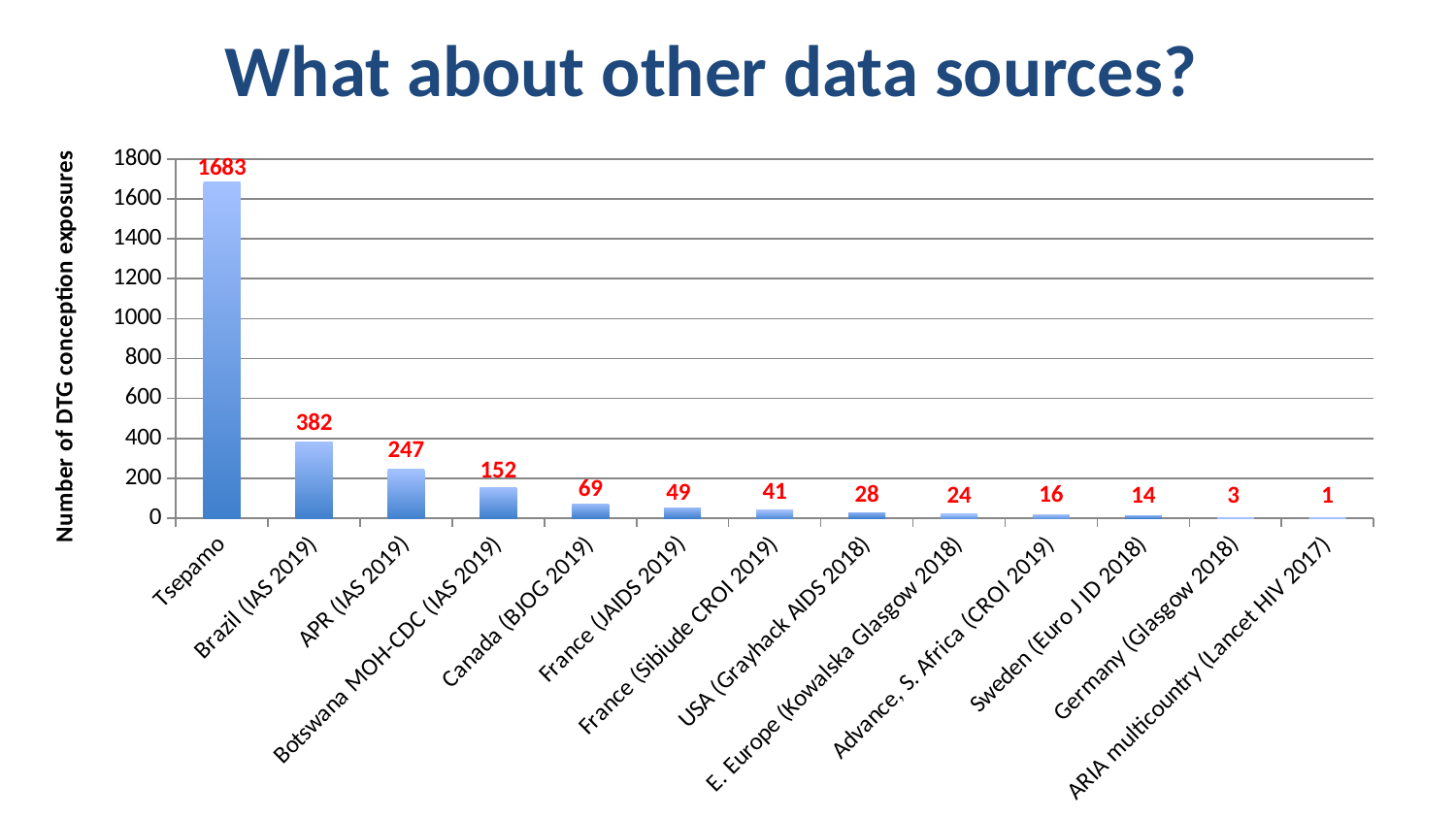
How many data sources are shown on the x axis? 13 What is the label of the y axis? Number of DTG conception exposures Do the values rise or fall moving from left to right along the x axis? Fall Is the value for APR (IAS 2019) greater or less than 200? greater What is the value shown for Canada (BJOG 2019)? 69 What kind of chart is shown on the slide? Bar chart What is the number of DTG conception exposures for Tsepamo? 1683 Which data source has the highest number of DTG conception exposures? Tsepamo Which has a larger value, Botswana MOH-CDC (IAS 2019) or France (JAIDS 2019)? Botswana MOH-CDC (IAS 2019) What is the number of DTG conception exposures for Brazil (IAS 2019)? 382 Which data source has the lowest number of DTG conception exposures? ARIA multicountry (Lancet HIV 2017) What is the difference between the values for Brazil (IAS 2019) and APR (IAS 2019)? 135